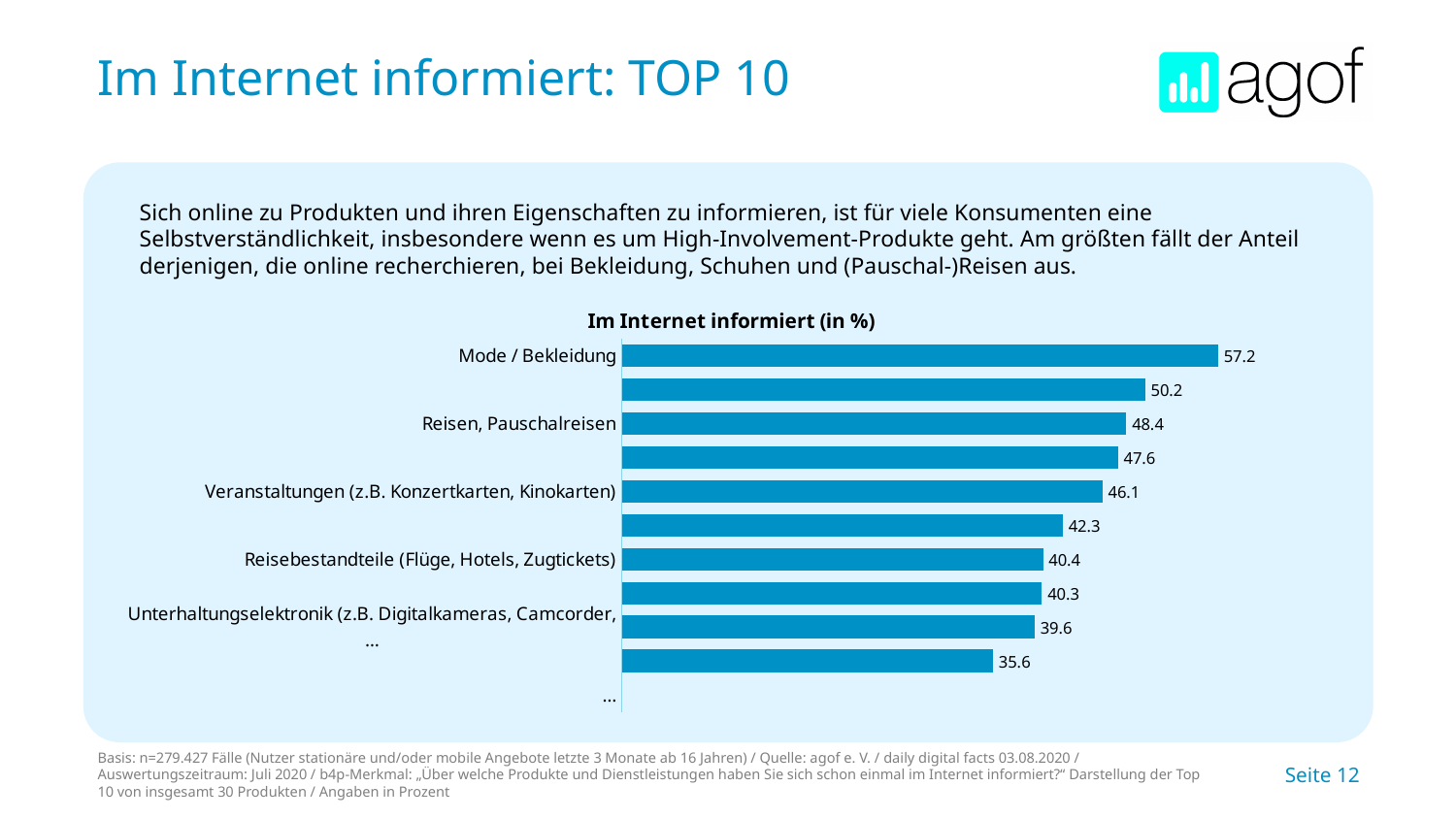
Which category has the highest value? Mode / Bekleidung What is the value for Veranstaltungen (z.B. Konzertkarten, Kinokarten)? 46.1 What is the value for Unterhaltungselektronik (z.B. Digitalkameras, Camcorder, …)? 39.6 How many bars are plotted in the chart? 10 What is the value for Mode / Bekleidung? 57.2 What is the value for Reisebestandteile (Flüge, Hotels, Zugtickets)? 40.4 What is the title of the chart? Im Internet informiert (in %) Which is larger, the value for Reisen, Pauschalreisen or the value for Unterhaltungselektronik (z.B. Digitalkameras, Camcorder, …)? Reisen, Pauschalreisen What is the value for Reisen, Pauschalreisen? 48.4 What is the difference between the values for Mode / Bekleidung and Reisen, Pauschalreisen? 8.8 What kind of chart is shown on the slide? Bar chart What is the difference between the values for Veranstaltungen (z.B. Konzertkarten, Kinokarten) and Reisebestandteile (Flüge, Hotels, Zugtickets)? 5.7